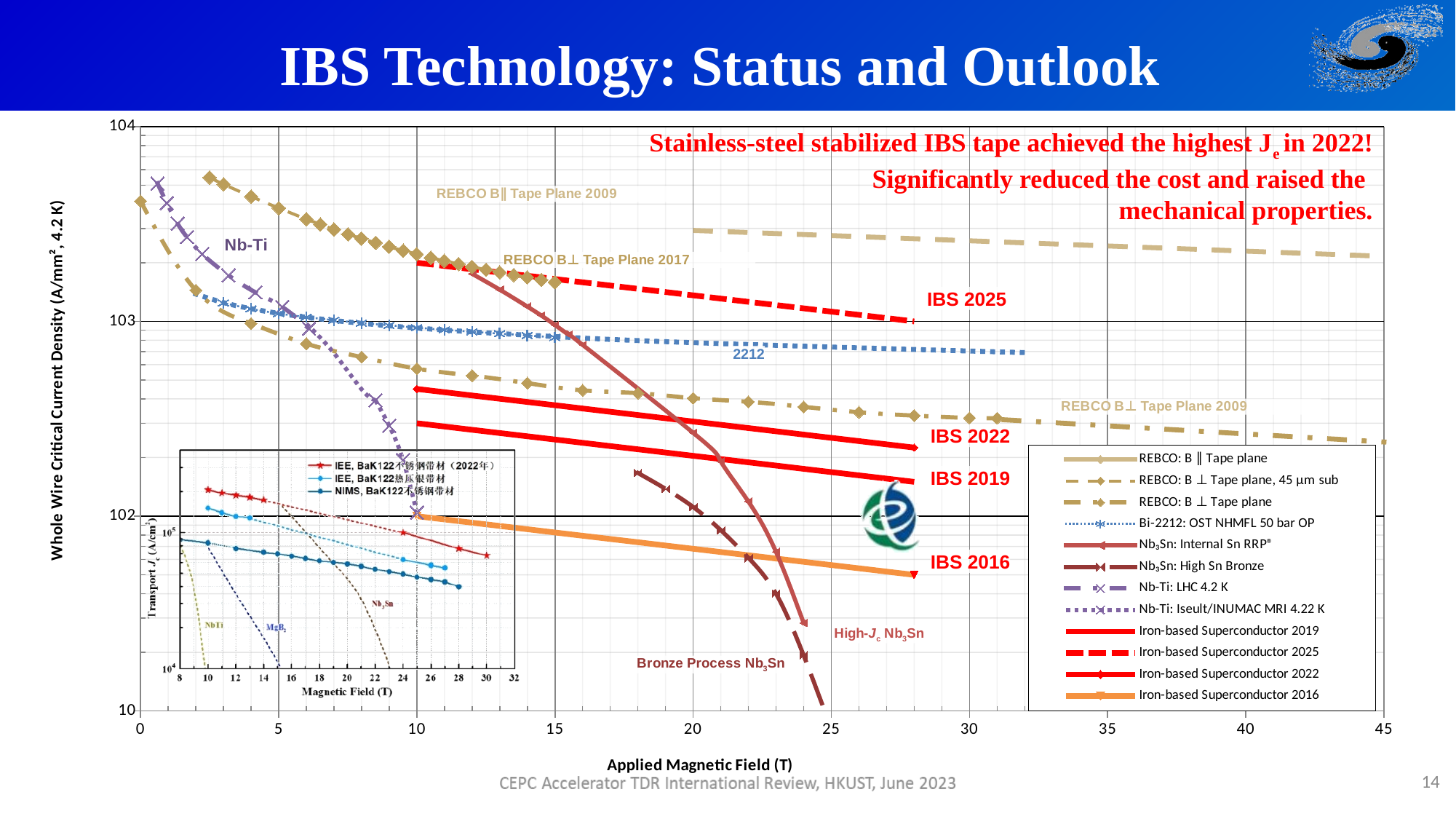
In the main chart, is the value for Bi-2212 at 30 T greater or less than 10³? less In the main chart, which of the IBS curves (2016, 2019, 2022, 2025) lies highest? IBS 2025 In the main chart, which of the IBS curves (2016, 2019, 2022, 2025) lies lowest? IBS 2016 What kind of chart is the main chart on the slide? line chart How many series does the legend of the inset chart list? 3 What is the label of the x axis of the main chart? Applied Magnetic Field (T) In the main chart, is the value for IBS 2016 at 28 T greater or less than 10²? less What is the label of the y axis of the main chart? Whole Wire Critical Current Density (A/mm², 4.2 K) In the main chart, how many Iron-based Superconductor series are listed in the legend? 4 In the main chart, does the IBS 2022 curve rise or fall as the applied magnetic field increases? fall How many series does the legend of the main chart list? 12 In the main chart, at 20 T, which is larger: the value for IBS 2022 or IBS 2019? IBS 2022